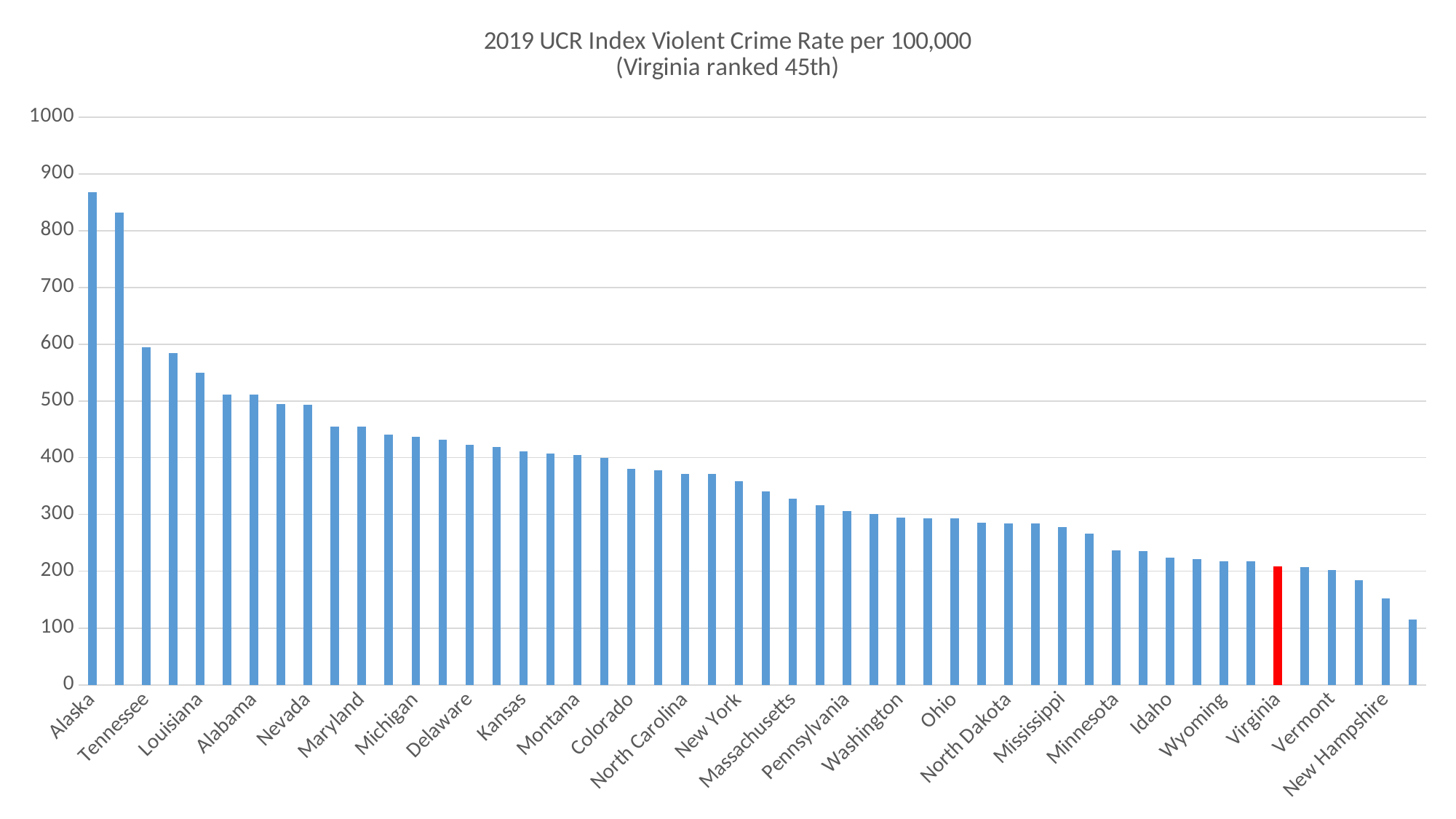
What kind of chart is shown on the slide? bar chart Is the value for Alaska greater or less than 800? greater Which state has the highest violent crime rate in the chart? Alaska Is the value for New Hampshire greater or less than 200? less Which has the larger value, Virginia or New Hampshire? Virginia Is the value for Louisiana greater or less than 600? less Which has the larger value, Louisiana or Alabama? Louisiana Which state's bar is coloured red? Virginia Do the values rise or fall moving from left to right along the x axis? fall